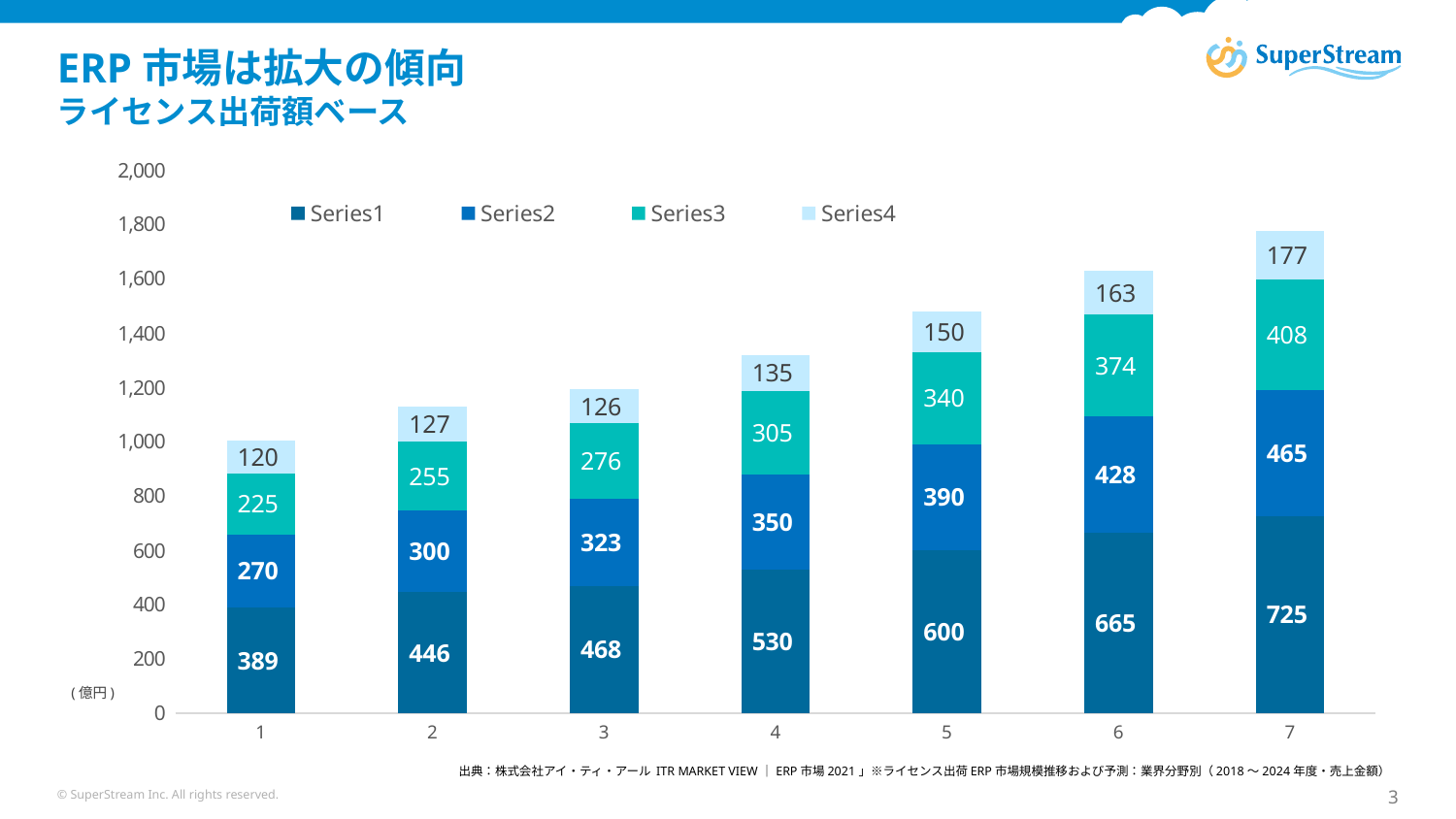
What is the total of the stacked bar for category 5? 1480 How many categories are shown on the x axis? 7 What is the total of the stacked bar for category 1? 1004 Do the total bar heights rise or fall from category 1 to category 7? rise Which category has the highest Series2 value? 7 What is the value of Series3 for category 5? 340 What is the value of Series1 for category 7? 725 What is the difference between the Series1 values for category 7 and category 1? 336 How many series does the legend list? 4 Which is larger: Series2 for category 4 or Series3 for category 6? Series3 for category 6 Which category has the lowest Series1 value? 1 What is the value of Series4 for category 1? 120